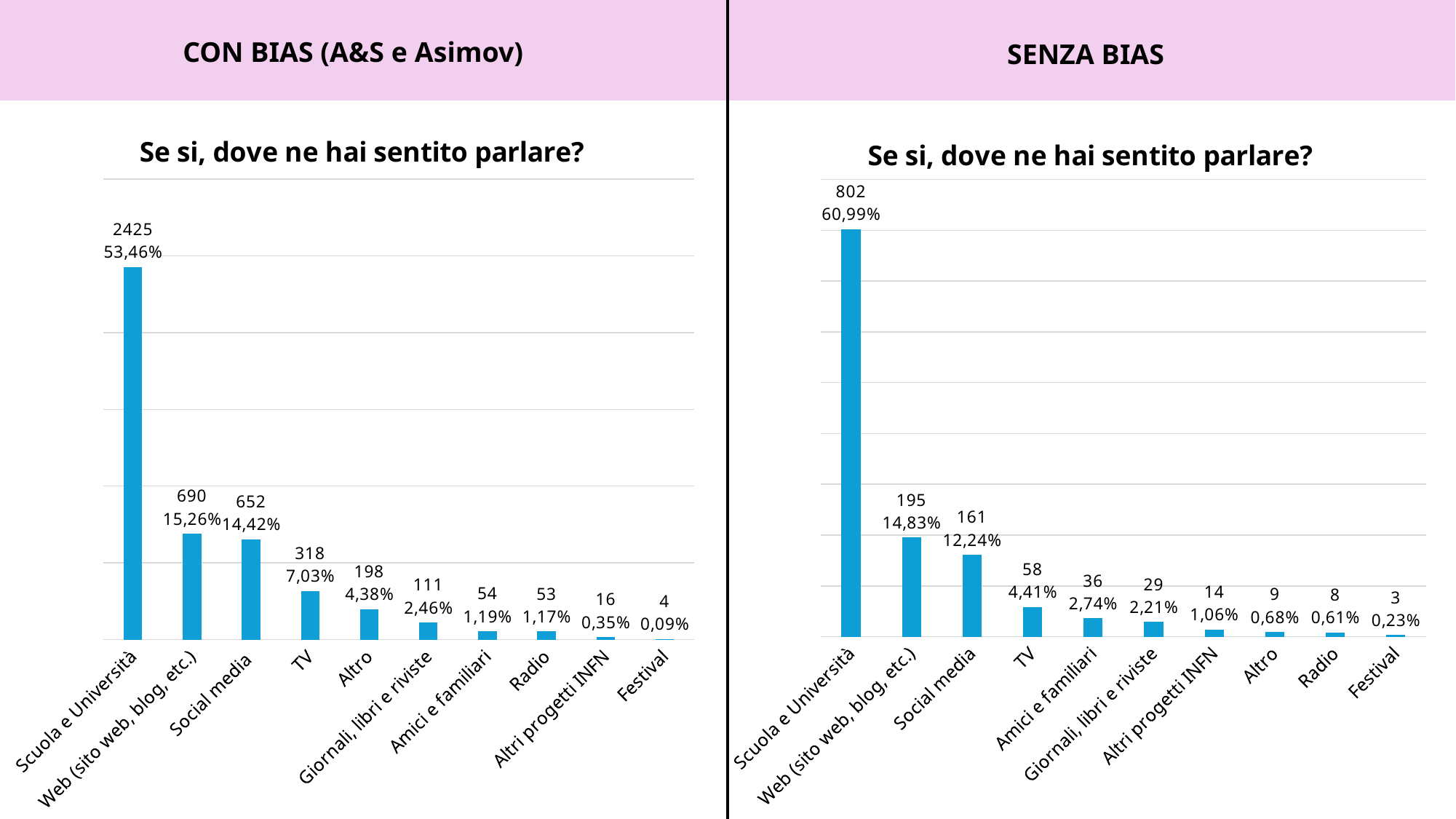
In the left chart (CON BIAS), which category has the lowest value? Festival In the left chart (CON BIAS), what percentage is shown for TV? 7,03% In the left chart (CON BIAS), what is the count for Scuola e Università? 2425 What is the title of the left chart (CON BIAS)? Se si, dove ne hai sentito parlare? In the right chart (SENZA BIAS), what is the count for Social media? 161 How many categories are shown in the left chart (CON BIAS)? 10 In the left chart (CON BIAS), what is the difference between the counts for Web (sito web, blog, etc.) and Social media? 38 In the right chart (SENZA BIAS), what is the difference between the counts for TV and Amici e familiari? 22 What type of chart is the right chart (SENZA BIAS)? Bar chart In the right chart (SENZA BIAS), which is larger, the value for Altro or the value for Altri progetti INFN? Altri progetti INFN In the right chart (SENZA BIAS), which category has the highest value? Scuola e Università In the right chart (SENZA BIAS), what percentage is shown for Scuola e Università? 60,99%